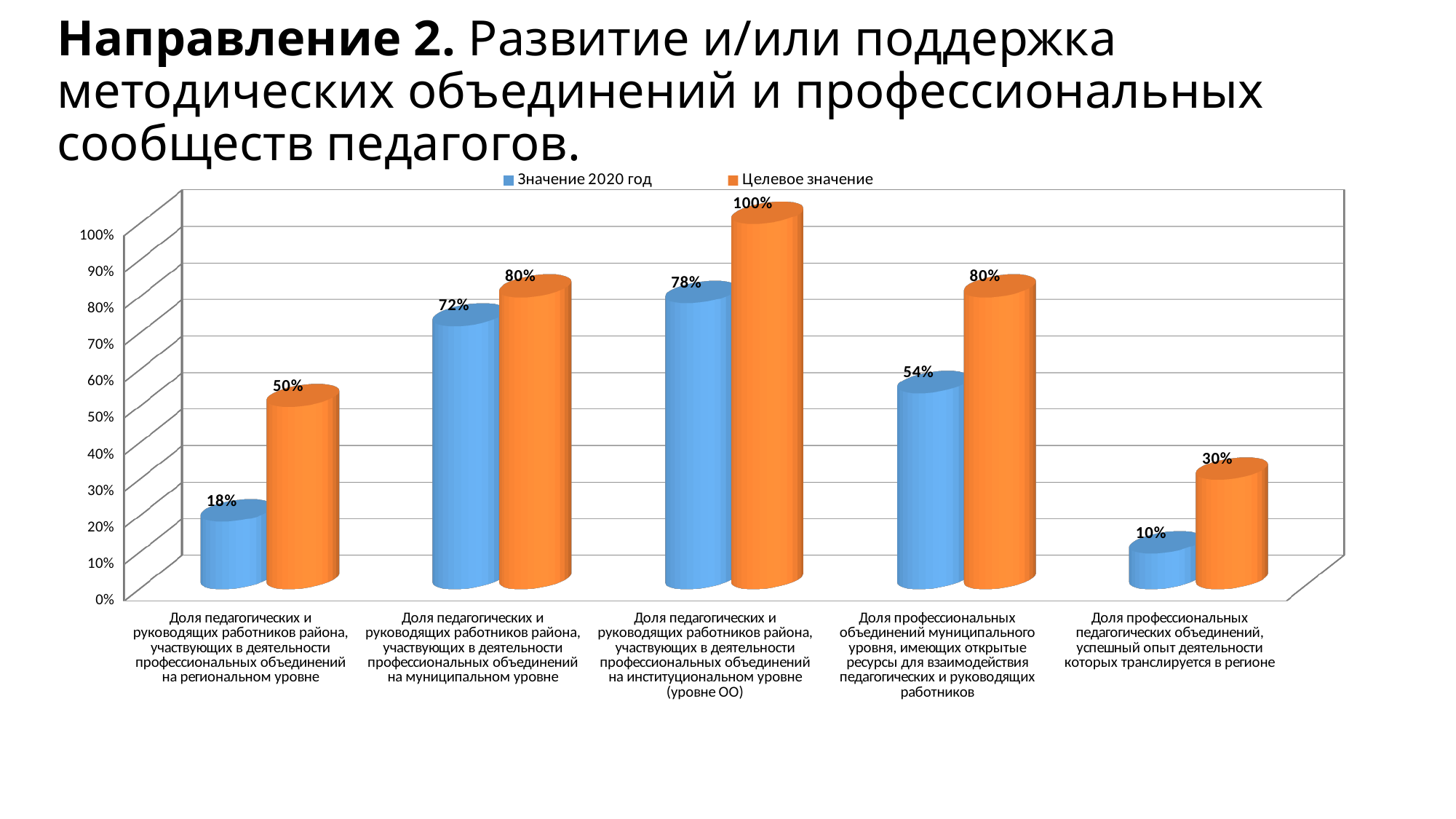
How many categories are shown on the x axis of the chart? 5 Which category has the highest 'Значение 2020 год'? Доля педагогических и руководящих работников района, участвующих в деятельности профессиональных объединений на институциональном уровне (уровне ОО) What is the 'Целевое значение' for the category 'Доля педагогических и руководящих работников района, участвующих в деятельности профессиональных объединений на институциональном уровне (уровне ОО)'? 100% What is the 'Значение 2020 год' for 'Доля профессиональных объединений муниципального уровня, имеющих открытые ресурсы для взаимодействия педагогических и руководящих работников'? 54% What kind of chart is shown on the slide? Bar chart Which colour represents the series 'Целевое значение' in the chart? Orange How many series does the legend list? 2 Which is larger for the category about the municipal level ('на муниципальном уровне'): the 'Значение 2020 год' or the 'Целевое значение'? Целевое значение What is the difference between the 'Целевое значение' and the 'Значение 2020 год' for 'Доля профессиональных педагогических объединений, успешный опыт деятельности которых транслируется в регионе'? 20% Which category has the lowest 'Целевое значение'? Доля профессиональных педагогических объединений, успешный опыт деятельности которых транслируется в регионе What is the difference between the 'Целевое значение' and the 'Значение 2020 год' for the category about the regional level ('на региональном уровне')? 32% What is the value for 'Значение 2020 год' for the category 'Доля педагогических и руководящих работников района, участвующих в деятельности профессиональных объединений на региональном уровне'? 18%